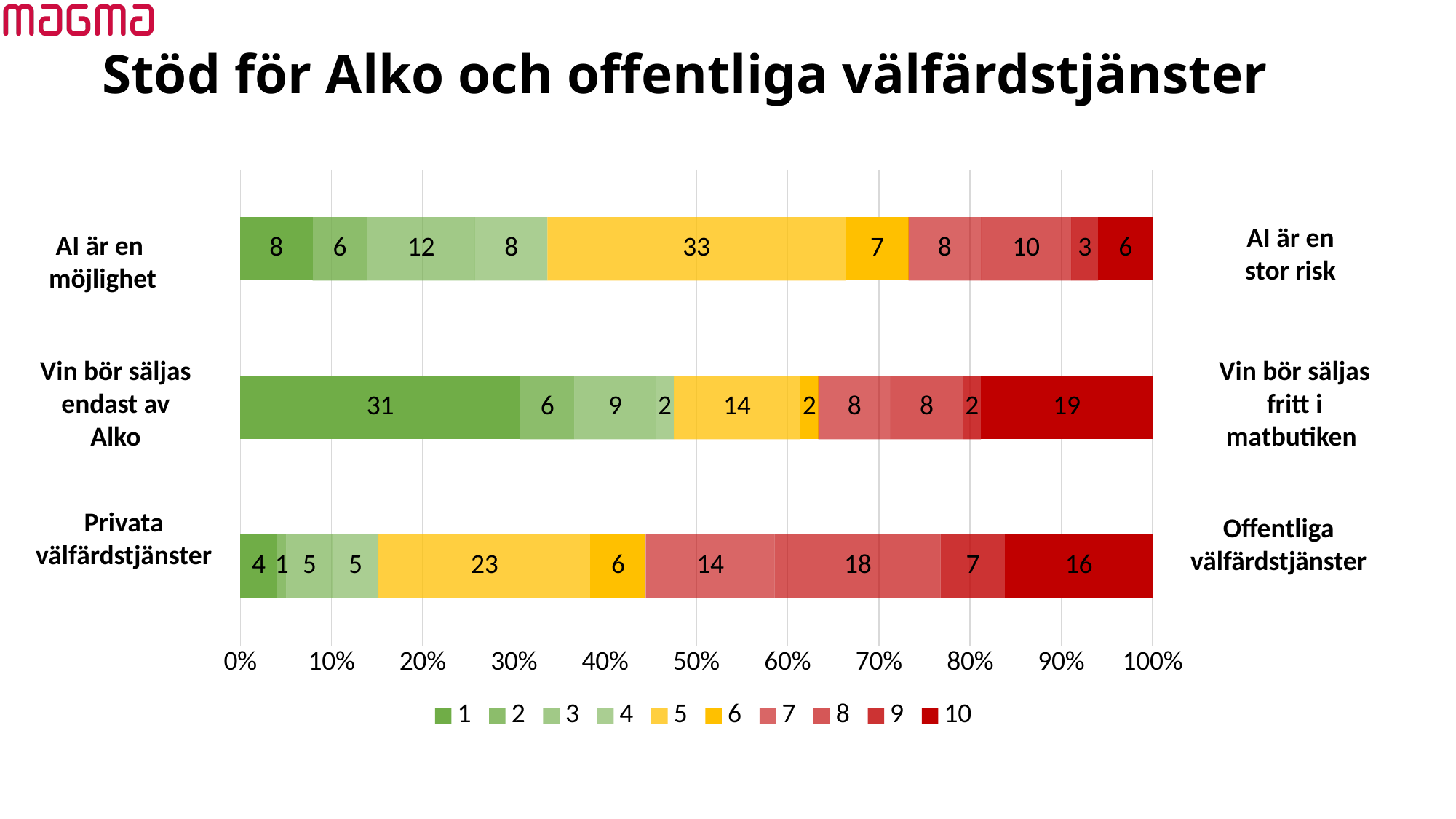
Which series has the largest segment in the 'Vin bör säljas endast av Alko' bar? 1 What is the value of series 8 in the 'Privata välfärdstjänster' bar? 18 What type of chart is shown on the slide? stacked bar chart What is the value of series 10 in the 'Privata välfärdstjänster' bar? 16 What is the value of series 1 in the 'Vin bör säljas endast av Alko' bar? 31 What is the difference between series 10 and series 1 in the 'Vin bör säljas endast av Alko' bar? 12 How many series does the legend list? 10 What is the value of series 5 in the 'AI är en möjlighet' bar? 33 Which series has the smallest segment in the 'Privata välfärdstjänster' bar? 2 What is the title of the chart on the slide? Stöd för Alko och offentliga välfärdstjänster How many bars (rows) are plotted in the chart? 3 In the 'AI är en möjlighet' bar, which is larger: series 3 or series 8? series 3